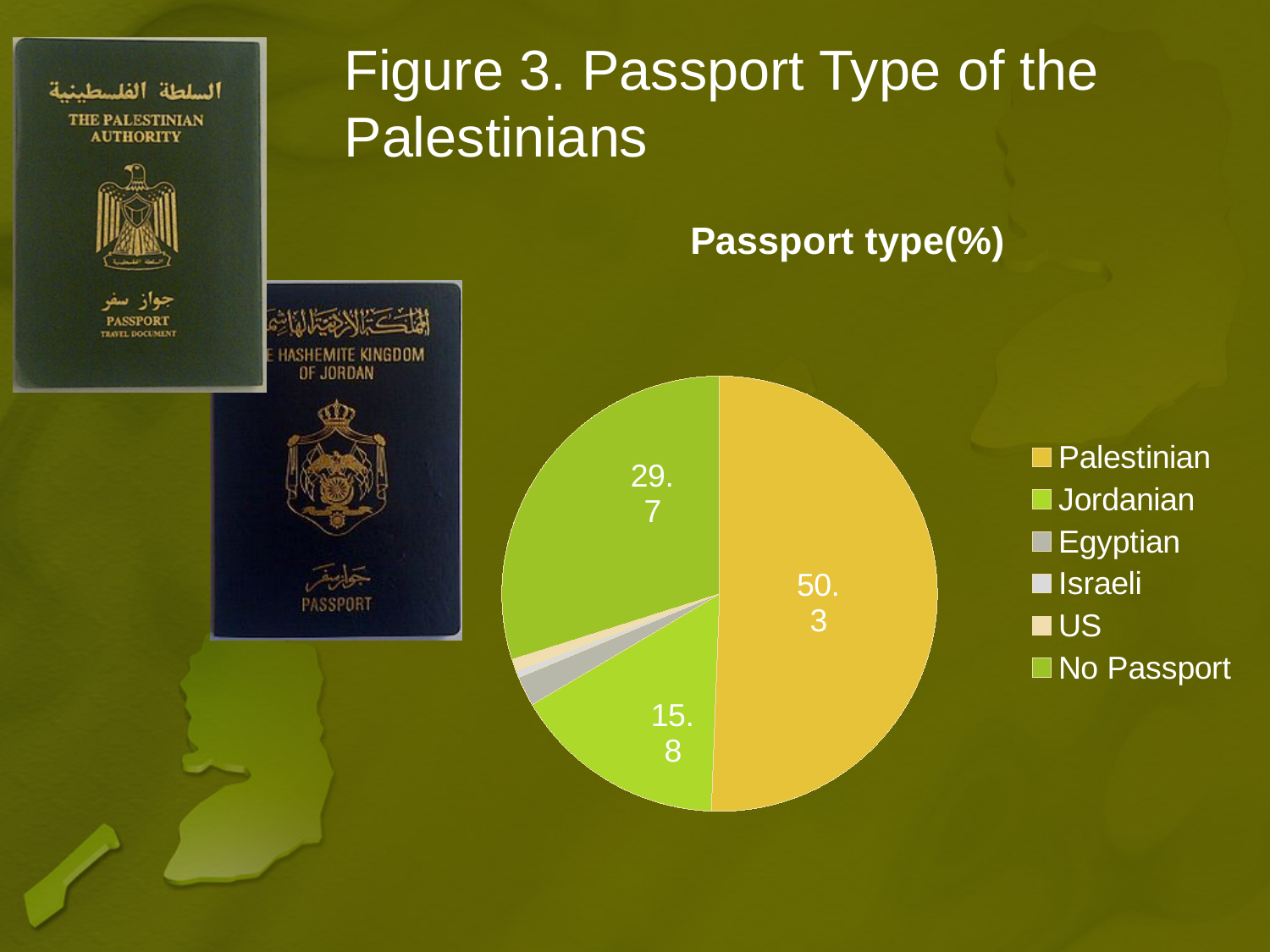
What is the title of the chart on the slide? Passport type(%) What value is shown for the No Passport slice of the pie chart? 29.7 Which is larger in the pie chart, the Palestinian slice or the Jordanian slice? Palestinian What is the difference between the No Passport and Jordanian values in the pie chart? 13.9 Which is larger in the pie chart, the Jordanian slice or the No Passport slice? No Passport What percentage of Palestinians hold a Palestinian passport according to the pie chart? 50.3 What kind of chart is used to show passport type? Pie chart Which passport type category has the largest slice in the pie chart? Palestinian What is the difference between the Palestinian and No Passport values in the pie chart? 20.6 What is the difference between the Palestinian and Jordanian values in the pie chart? 34.5 What value is shown for the Jordanian slice of the pie chart? 15.8 How many passport type categories are listed in the chart's legend? 6